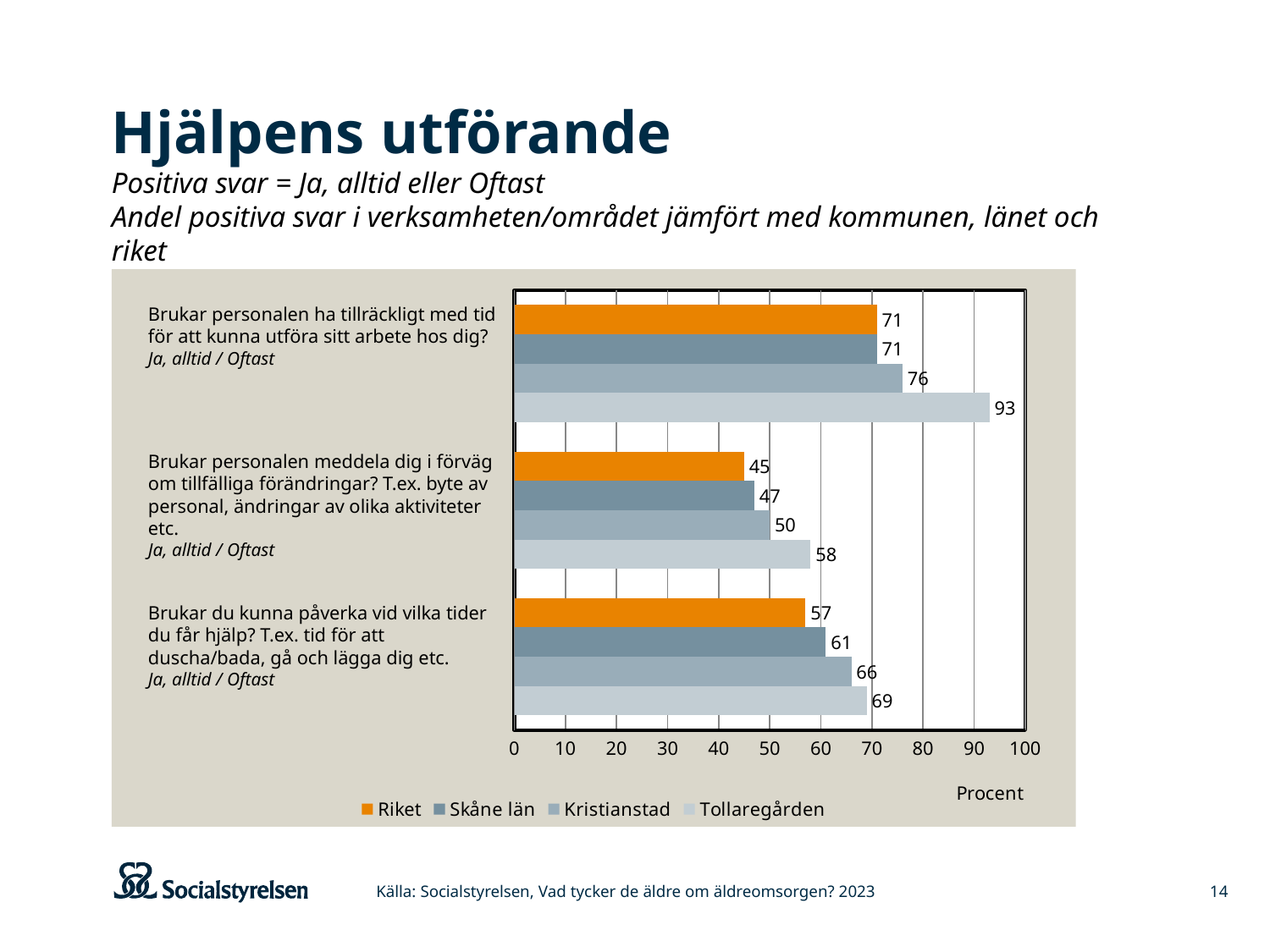
How many question categories are shown on the chart? 3 What is the value for Skåne län on the question 'Brukar personalen ha tillräckligt med tid för att kunna utföra sitt arbete hos dig?' 71 Which series has the highest value on the question 'Brukar personalen meddela dig i förväg om tillfälliga förändringar?' Tollaregården What type of chart is shown on the slide? Bar chart What is the value for Tollaregården on the question 'Brukar personalen ha tillräckligt med tid för att kunna utföra sitt arbete hos dig?' 93 Which is larger on the question 'Brukar du kunna påverka vid vilka tider du får hjälp?': Skåne län or Kristianstad? Kristianstad What is the value for Riket on the question 'Brukar personalen meddela dig i förväg om tillfälliga förändringar?' 45 Which series has the lowest value on the question 'Brukar du kunna påverka vid vilka tider du får hjälp?' Riket What unit is shown on the x axis of the chart? Procent What is the difference between Tollaregården and Riket on the question 'Brukar personalen ha tillräckligt med tid för att kunna utföra sitt arbete hos dig?' 22 How many series does the legend list? 4 What is the value for Kristianstad on the question 'Brukar du kunna påverka vid vilka tider du får hjälp?' 66